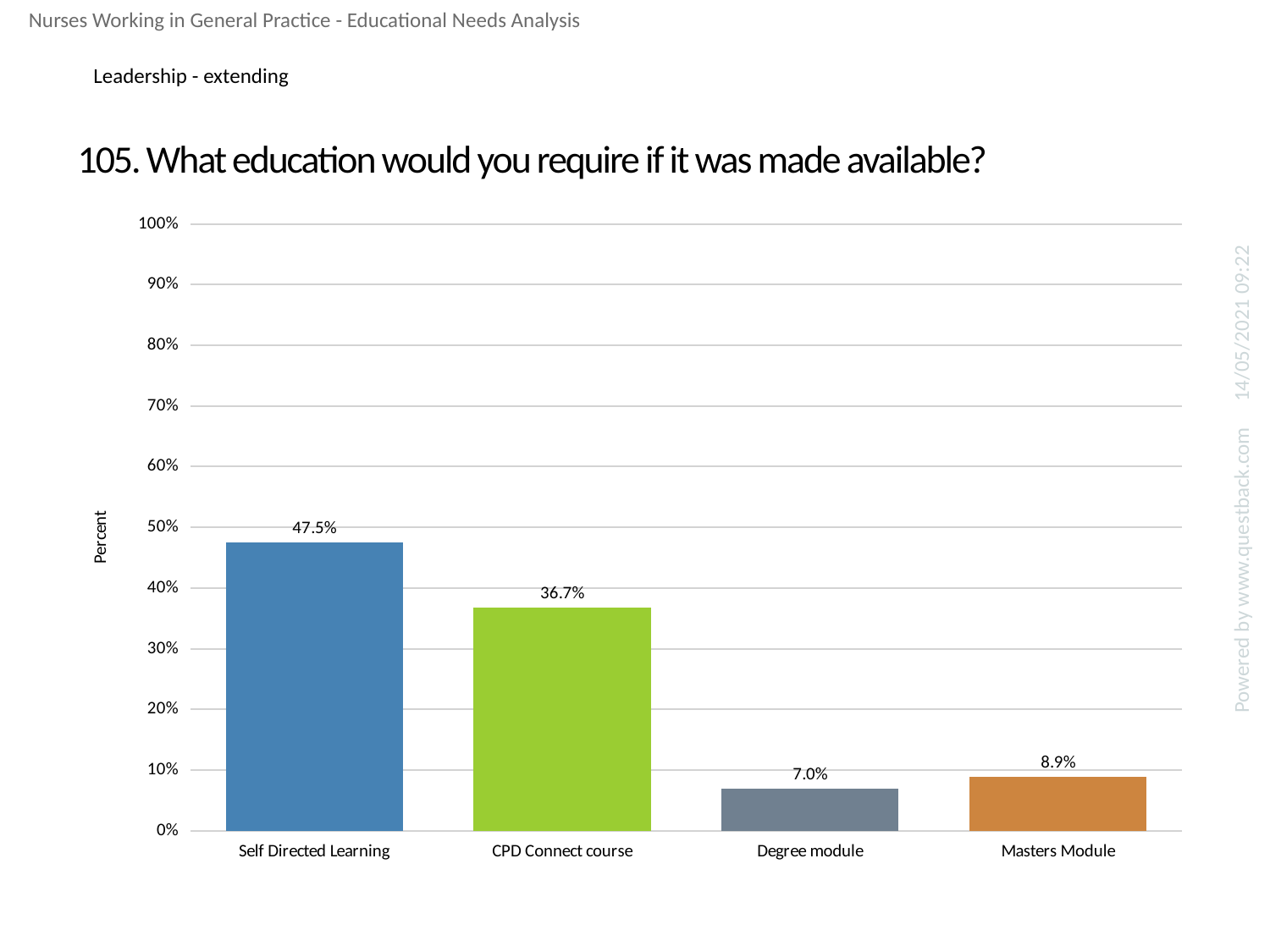
What is the label on the vertical axis? Percent Which category has the lowest value? Degree module Which is larger, the value for Masters Module or the value for Degree module? Masters Module Which category has the highest value? Self Directed Learning What is the value for Degree module? 7.0% What kind of chart is shown on the slide? bar chart What is the value for CPD Connect course? 36.7% What is the difference between the values for Self Directed Learning and CPD Connect course? 10.8% What is the value for Masters Module? 8.9% How many categories are shown on the x axis? 4 What is the value for Self Directed Learning? 47.5% Is the value for CPD Connect course greater or less than 40%? less